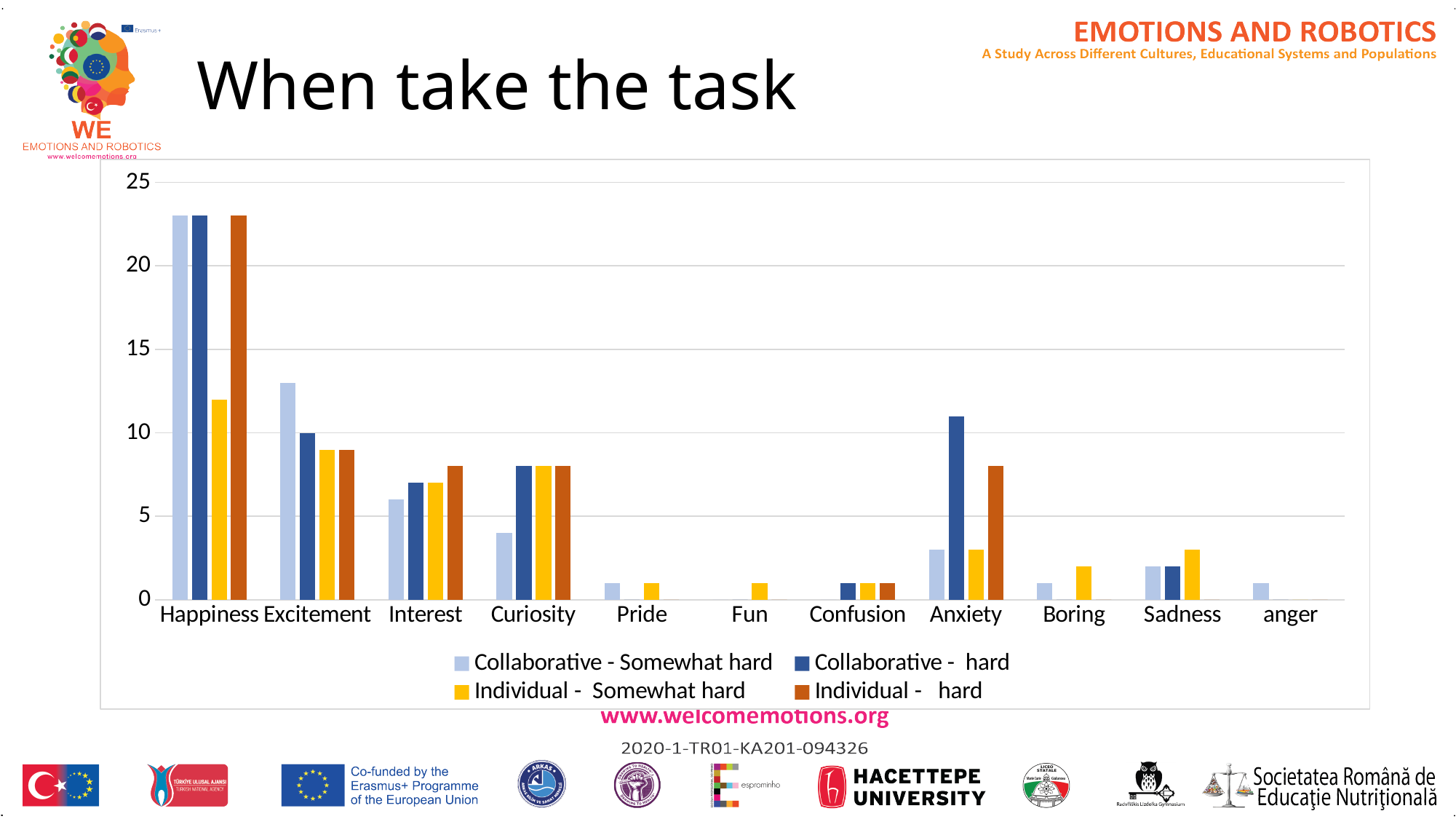
Is the Collaborative - hard value for Anxiety greater or less than 10? greater Is the Collaborative - hard value for Happiness greater or less than 20? greater Is the Collaborative - Somewhat hard value for Excitement greater or less than 10? greater How many emotion categories are shown on the x axis of the chart? 11 How many series does the chart's legend list? 4 Which category has the highest value for the Collaborative - Somewhat hard series? Happiness For Anxiety, which is larger: the Collaborative - hard value or the Individual - hard value? Collaborative - hard Which series is shown in yellow in the chart's legend? Individual - Somewhat hard What kind of chart is shown on the slide? bar chart Which category has the highest value for the Individual - hard series? Happiness For Happiness, which is larger: the Individual - Somewhat hard value or the Individual - hard value? Individual - hard